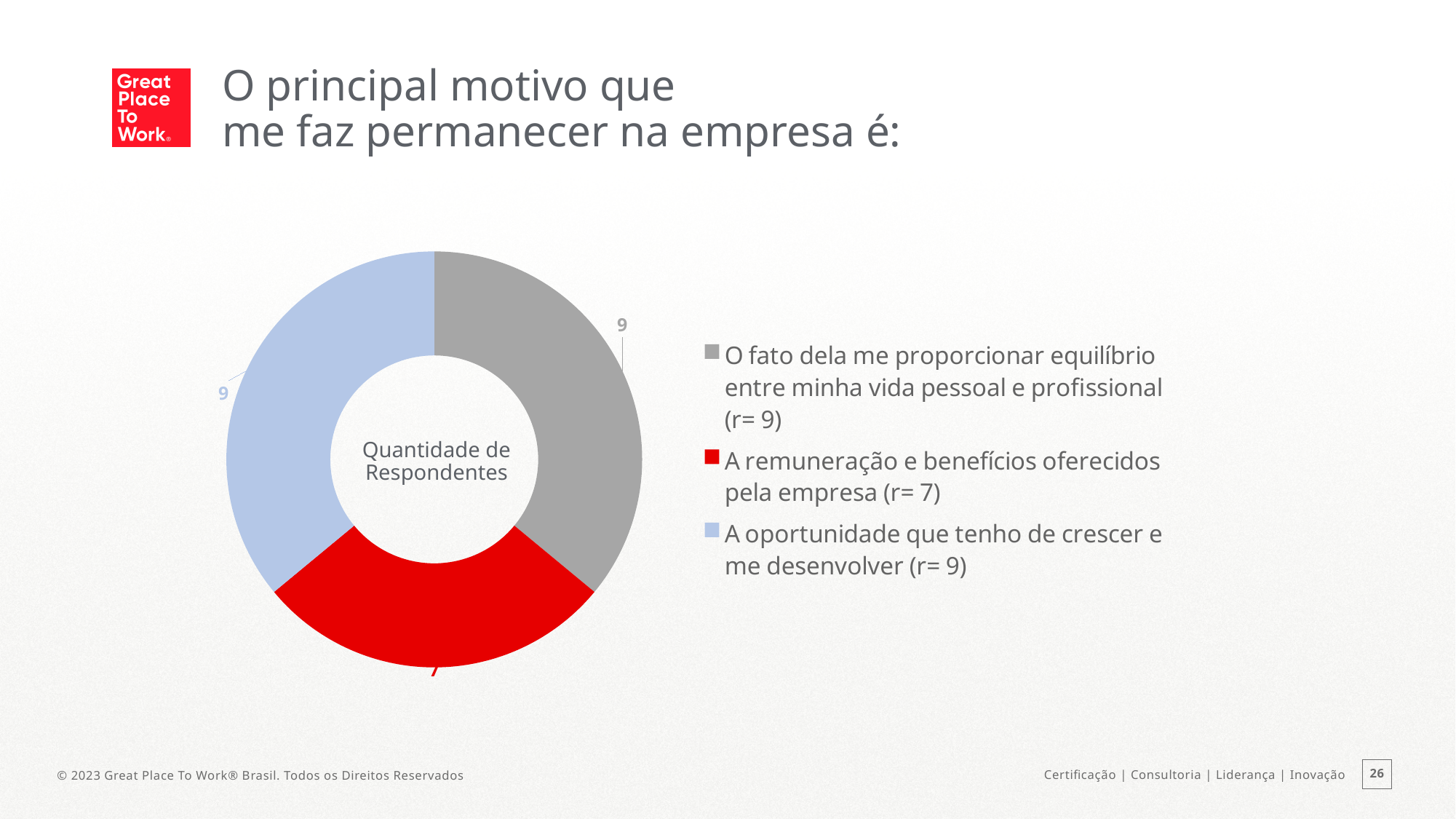
How many categories does the doughnut chart show? 3 What kind of chart is shown on the slide? Doughnut (pie) chart What colour is the slice for "A remuneração e benefícios oferecidos pela empresa"? Red Which category has the lowest value? A remuneração e benefícios oferecidos pela empresa What is the value for "A oportunidade que tenho de crescer e me desenvolver"? 9 Which is larger: the value for "O fato dela me proporcionar equilíbrio entre minha vida pessoal e profissional" or for "A remuneração e benefícios oferecidos pela empresa"? O fato dela me proporcionar equilíbrio entre minha vida pessoal e profissional What share of the total does the "A remuneração e benefícios oferecidos pela empresa" slice represent? 28% What is the value for "O fato dela me proporcionar equilíbrio entre minha vida pessoal e profissional"? 9 What text is shown in the centre of the doughnut chart? Quantidade de Respondentes What is the value for "A remuneração e benefícios oferecidos pela empresa"? 7 What is the difference between the value for "A oportunidade que tenho de crescer e me desenvolver" and the value for "A remuneração e benefícios oferecidos pela empresa"? 2 What is the total number of respondents across all three slices? 25